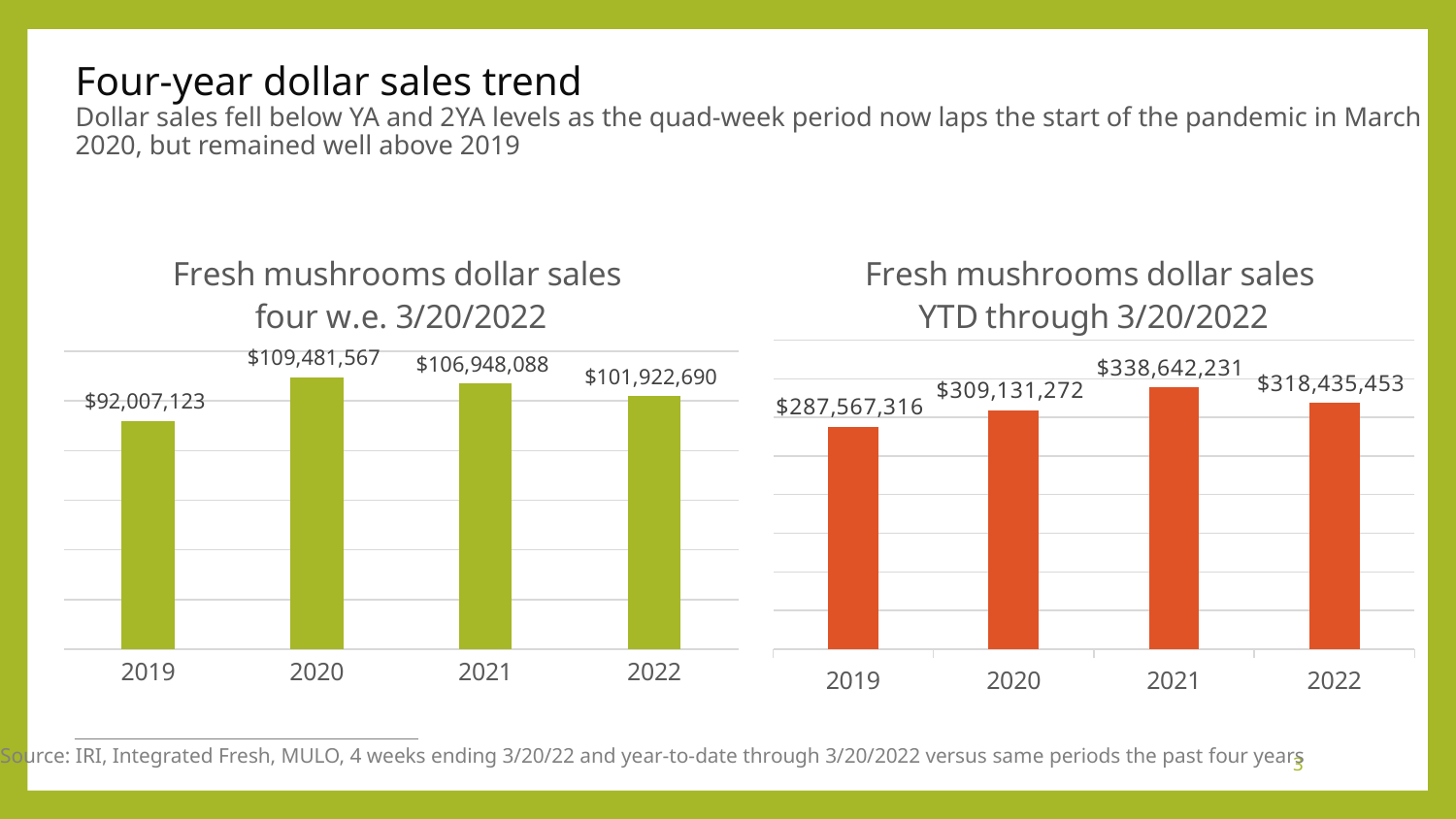
In the 'Fresh mushrooms dollar sales YTD through 3/20/2022' chart, what is the value for 2020? $309,131,272 In the 'Fresh mushrooms dollar sales four w.e. 3/20/2022' chart, which is larger, the value for 2021 or the value for 2022? 2021 How many years are shown in the 'Fresh mushrooms dollar sales YTD through 3/20/2022' chart? 4 In the 'Fresh mushrooms dollar sales YTD through 3/20/2022' chart, what is the value for 2022? $318,435,453 What type of chart is the 'Fresh mushrooms dollar sales four w.e. 3/20/2022' chart? Bar chart In the 'Fresh mushrooms dollar sales four w.e. 3/20/2022' chart, what is the difference between the 2020 and 2019 values? $17,474,444 In the 'Fresh mushrooms dollar sales YTD through 3/20/2022' chart, which year has the highest value? 2021 In the 'Fresh mushrooms dollar sales YTD through 3/20/2022' chart, what is the difference between the 2021 and 2022 values? $20,206,778 In the 'Fresh mushrooms dollar sales four w.e. 3/20/2022' chart, which year has the highest value? 2020 In the 'Fresh mushrooms dollar sales four w.e. 3/20/2022' chart, what is the value for 2019? $92,007,123 In the 'Fresh mushrooms dollar sales YTD through 3/20/2022' chart, which year has the lowest value? 2019 In the 'Fresh mushrooms dollar sales four w.e. 3/20/2022' chart, what is the value for 2022? $101,922,690